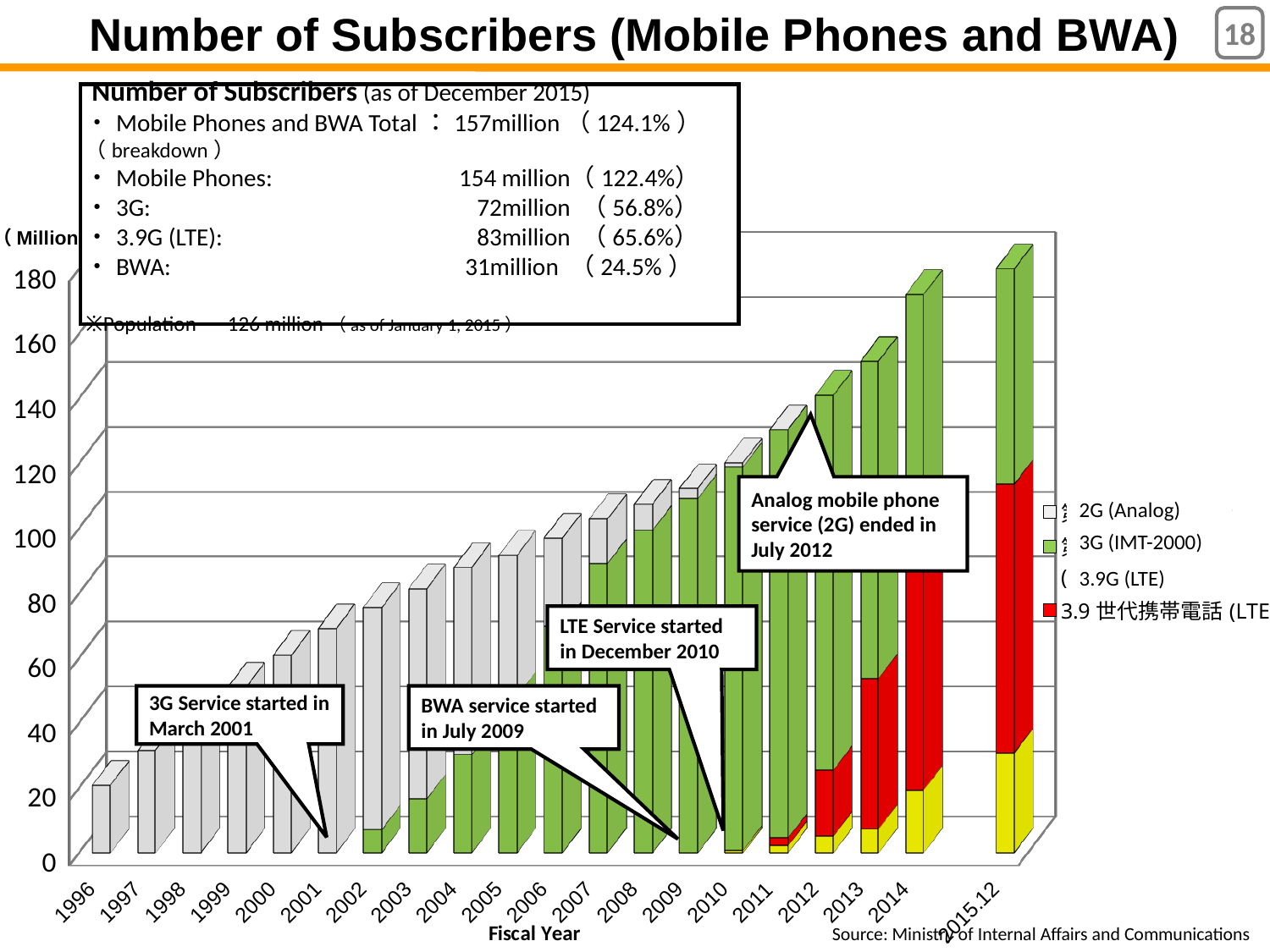
What unit is indicated for the y axis of the chart? Million What kind of chart is shown on the slide? Stacked bar chart Is the total value for 2015.12 greater or less than 160? greater Which fiscal year has the highest total number of subscribers in the chart? 2015.12 Do the total subscriber numbers rise or fall from 1996 to 2015.12? Rise Which has the larger total number of subscribers, 2010 or 2014? 2014 How many fiscal-year categories are shown on the x axis of the chart? 20 Which fiscal year has the lowest total number of subscribers in the chart? 1996 Is the total value for 1996 greater or less than 40? less Is the total value for 2010 greater or less than 100? greater What is the title of the x axis of the chart? Fiscal Year